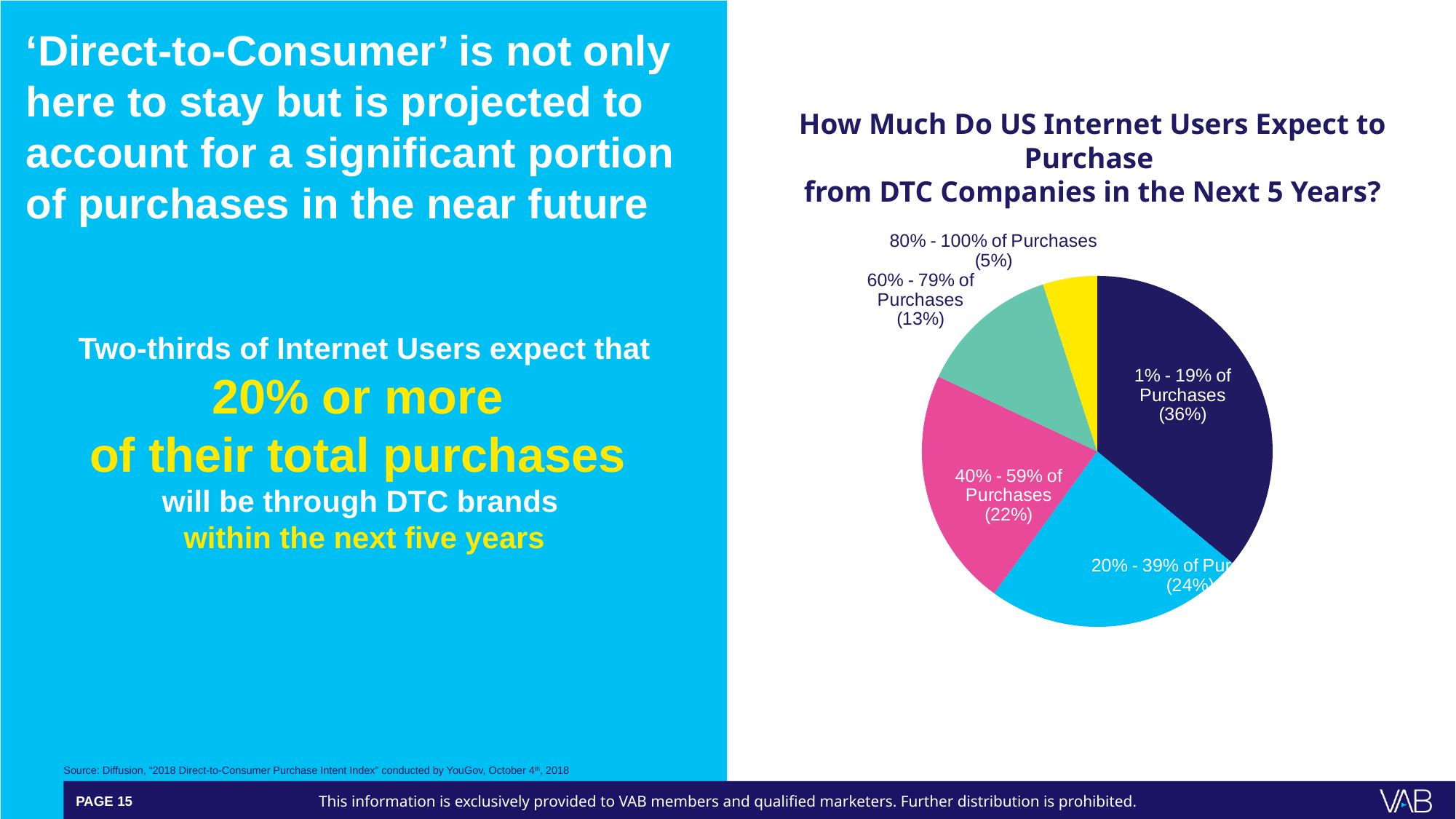
What is the title of the pie chart? How Much Do US Internet Users Expect to Purchase from DTC Companies in the Next 5 Years? What kind of chart is shown on the slide? Pie chart How many slices does the pie chart have? 5 What share of US internet users expect 80% - 100% of purchases to come from DTC companies? 5% What share of US internet users expect 60% - 79% of purchases to come from DTC companies? 13% Which is larger: the 40% - 59% of Purchases slice or the 60% - 79% of Purchases slice? 40% - 59% of Purchases What share of US internet users expect 40% - 59% of purchases to come from DTC companies? 22% What share of US internet users expect 1% - 19% of purchases to come from DTC companies? 36% Which purchase range has the smallest slice of the pie? 80% - 100% of Purchases What is the difference in percentage points between the 1% - 19% of Purchases slice and the 20% - 39% of Purchases slice? 12 percentage points Which purchase range has the largest slice of the pie? 1% - 19% of Purchases What share of US internet users expect 20% - 39% of purchases to come from DTC companies? 24%